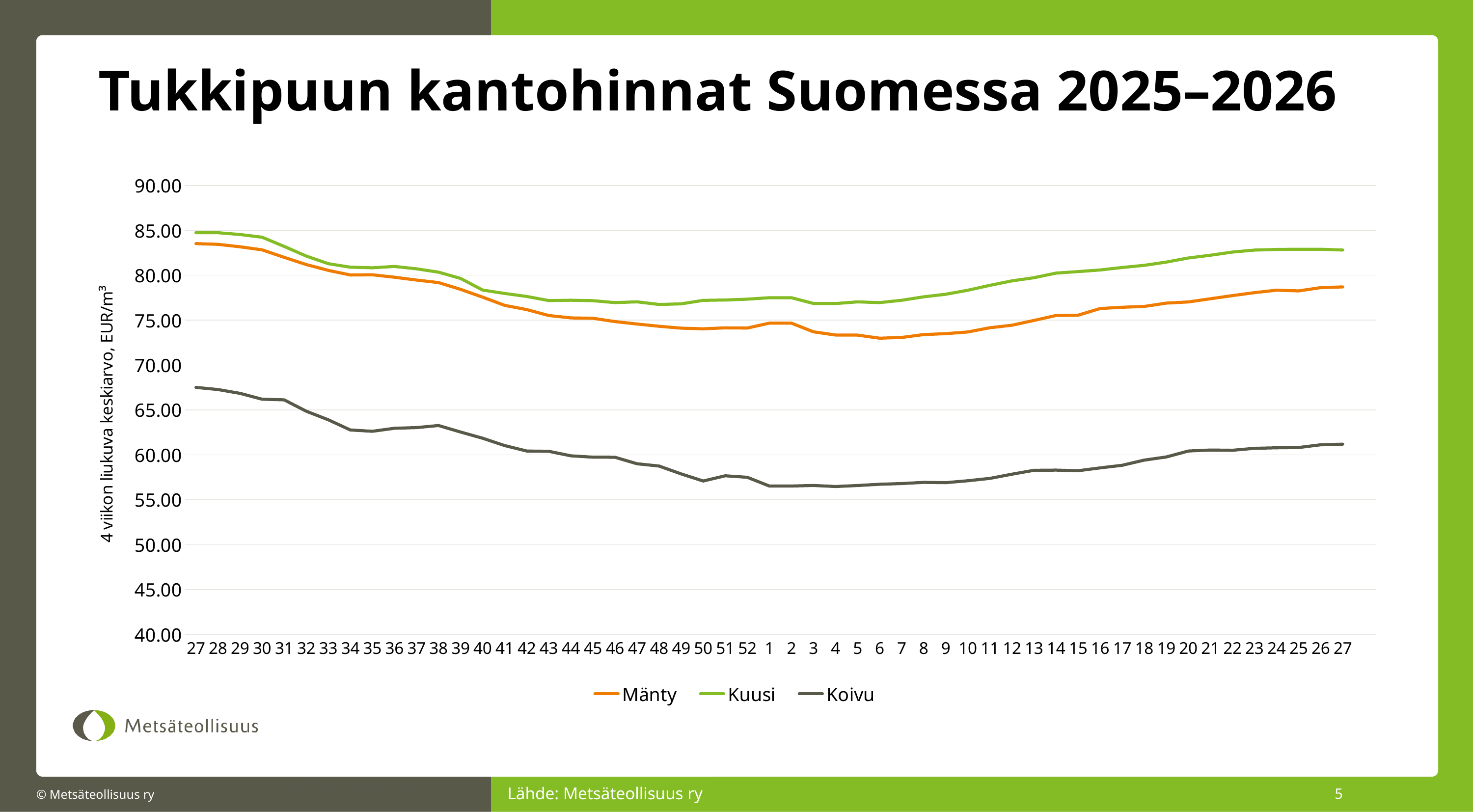
Is the value for Kuusi at the last point (week 27) greater or less than 80.00? greater Which series has the lowest values throughout the chart? Koivu At week 40, which is larger, the value for Kuusi or the value for Mänty? Kuusi How many series does the legend list? 3 What is the title of the chart? Tukkipuun kantohinnat Suomessa 2025–2026 Does the Koivu line rise or fall from week 27 to week 1? fall What kind of chart is shown on the slide? line chart Is the value for Koivu at week 1 greater or less than 60.00? less Which series has the highest values throughout the chart? Kuusi Does the Mänty line rise or fall from week 7 to the final week 27? rise Is the value for Mänty at week 6 greater or less than 75.00? less